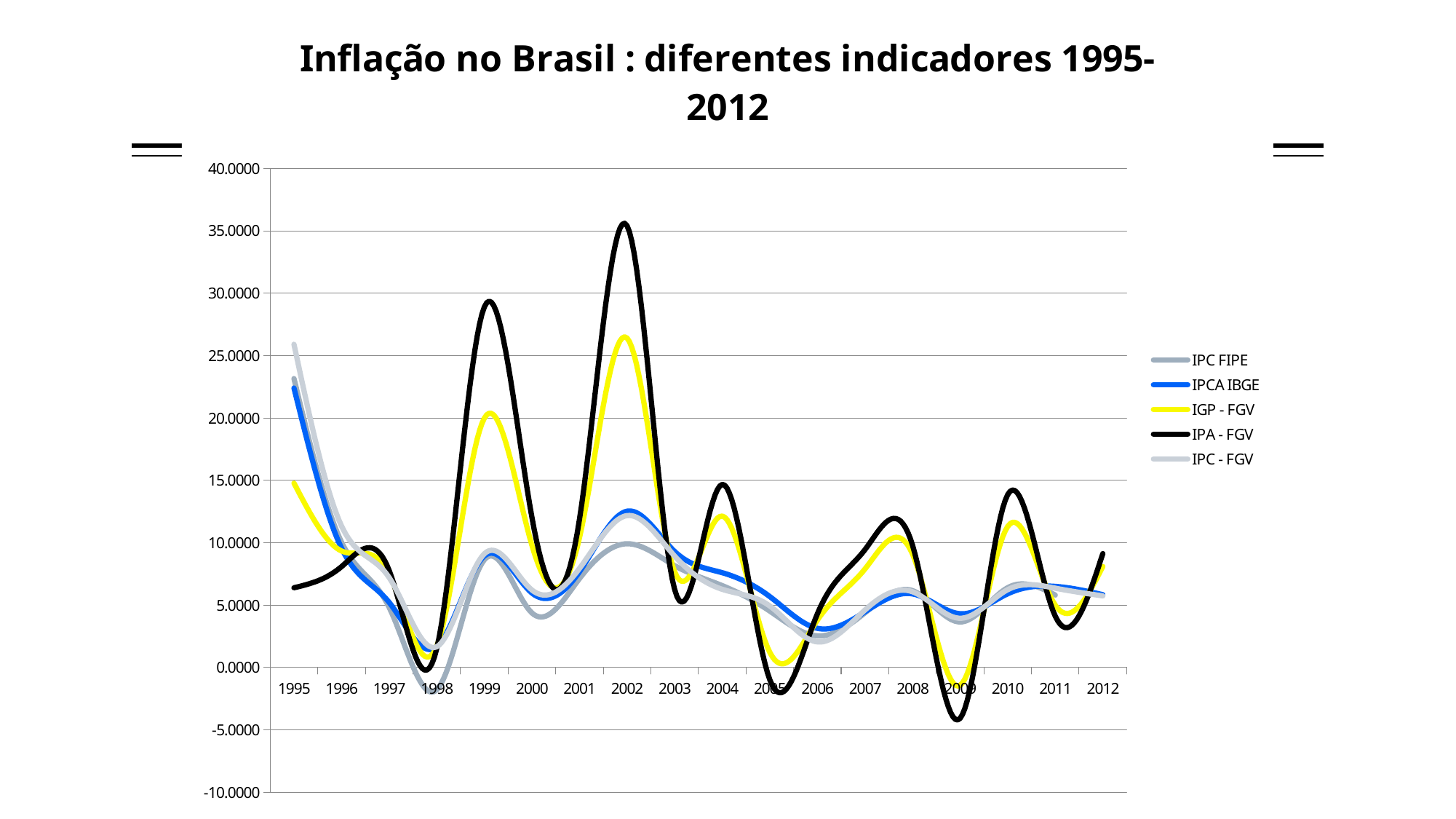
How many series does the legend list? 5 In 1995, which is larger: IPCA IBGE or IPA - FGV? IPCA IBGE Is the value for IPA - FGV in 2002 greater or less than 30.0000? greater In 2002, which is larger: IPA - FGV or IPCA IBGE? IPA - FGV Is the value for IPA - FGV in 1995 greater or less than 10.0000? less Is the value for IPA - FGV in 2009 greater or less than 0.0000? less What kind of chart is shown on the slide? line chart What is the title of the chart? Inflação no Brasil : diferentes indicadores 1995-2012 How many years are shown along the x axis? 18 Which series reaches the highest value anywhere on the chart? IPA - FGV In which year does the IPA - FGV series reach its highest peak? 2002